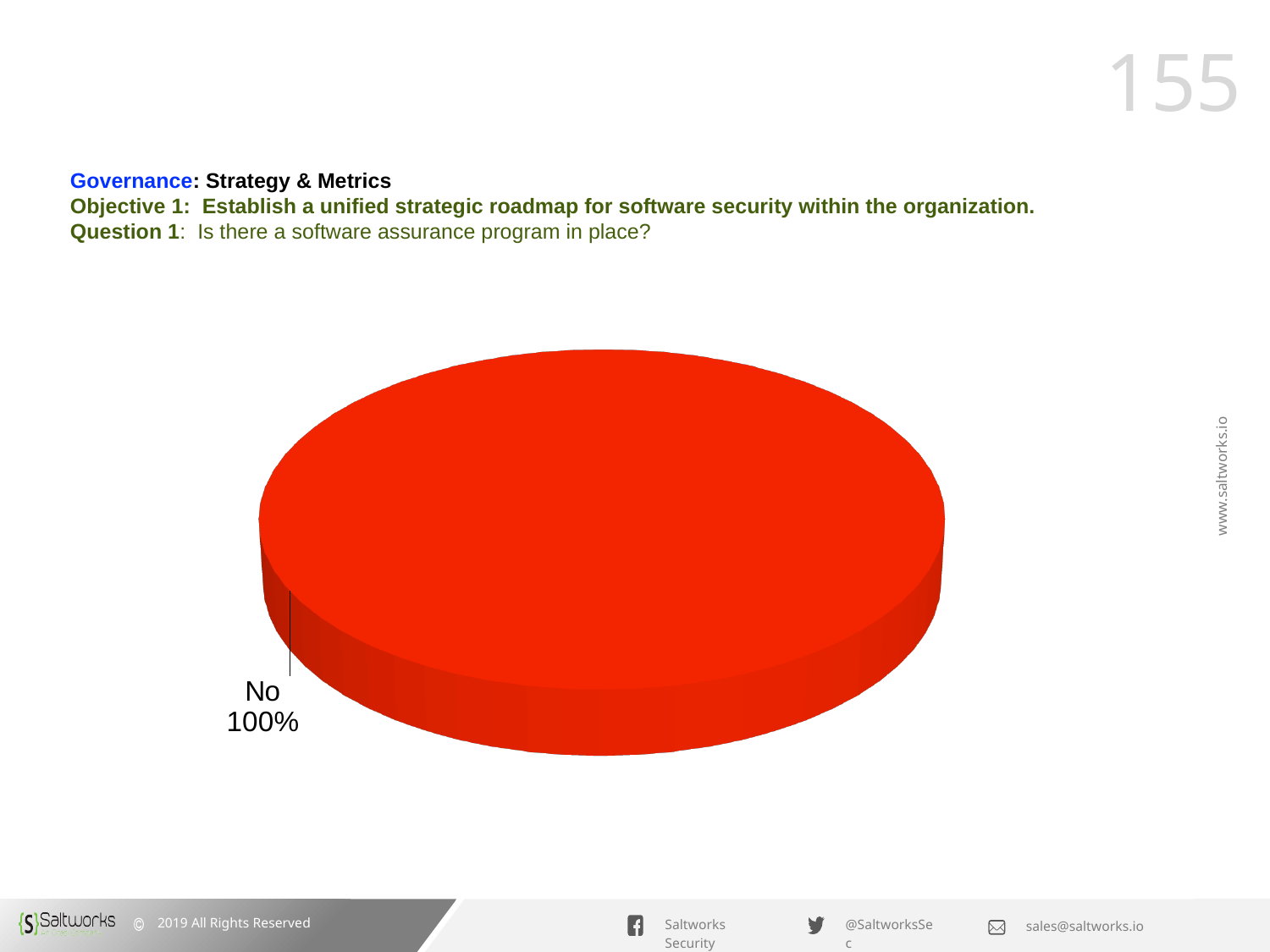
What question does the pie chart answer, according to the text above it? Is there a software assurance program in place? Which category makes up the entire pie chart? No What is the label of the only slice in the pie chart? No What share of the pie does the "No" slice represent? 100% What kind of chart is shown on the slide? pie chart What colour is the "No" slice of the pie chart? red Is the share for "No" greater or less than 50%? greater How many slices does the pie chart have? 1